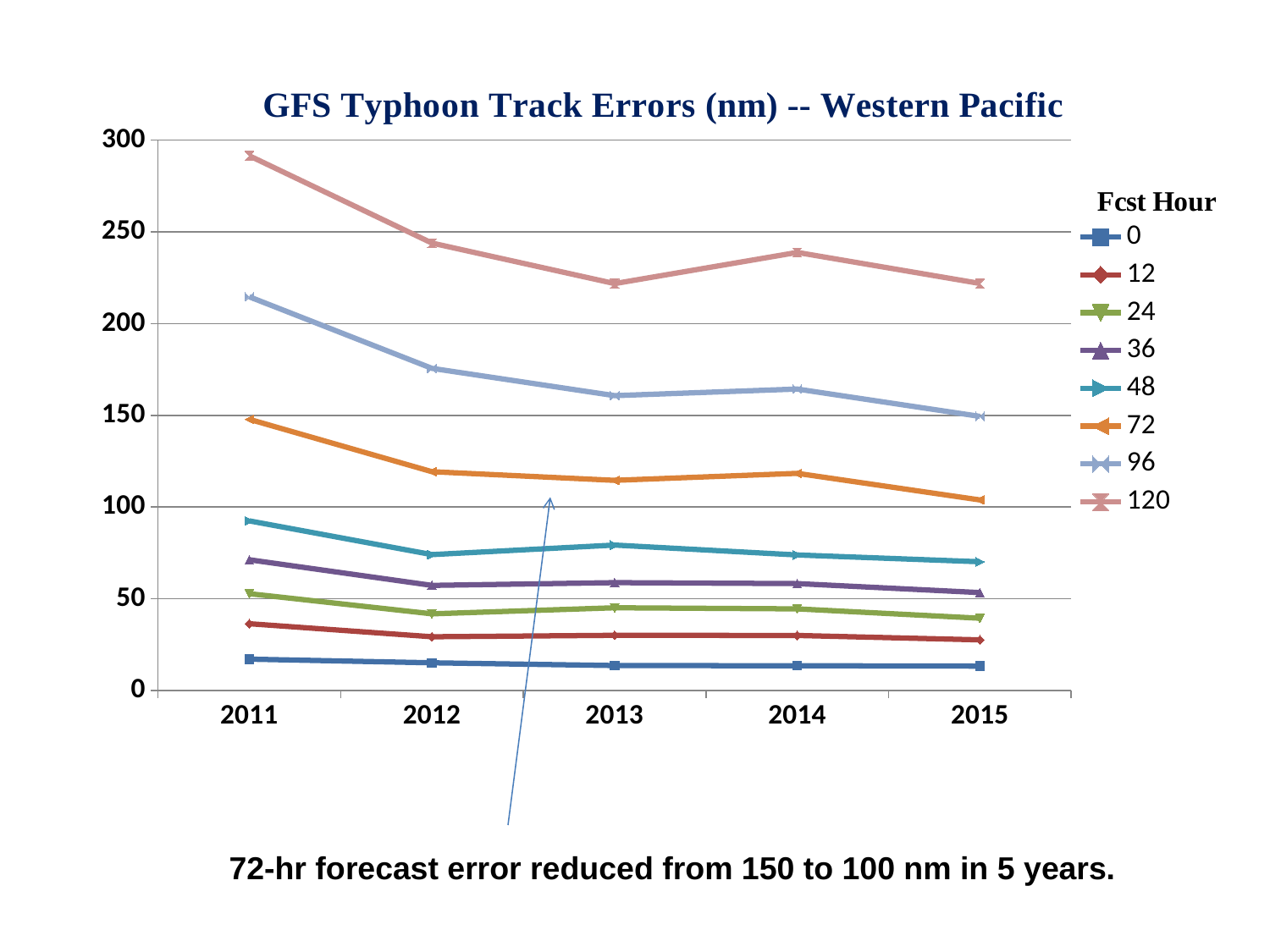
Is the 48-hour track error in 2011 greater or less than 50? greater How many years are shown along the x axis? 5 Is the 120-hour track error in 2011 greater or less than 250? greater What is the title of the chart? GFS Typhoon Track Errors (nm) -- Western Pacific Is the 96-hour track error in 2011 greater or less than 200? greater Which forecast hour series has the highest track errors across all years? 120 In which year is the 120-hour forecast track error highest? 2011 Which forecast hour series has the lowest track errors across all years? 0 What kind of chart is shown on the slide? line chart Does the 120-hour track error rise or fall from 2011 to 2012? fall How many series does the legend list? 8